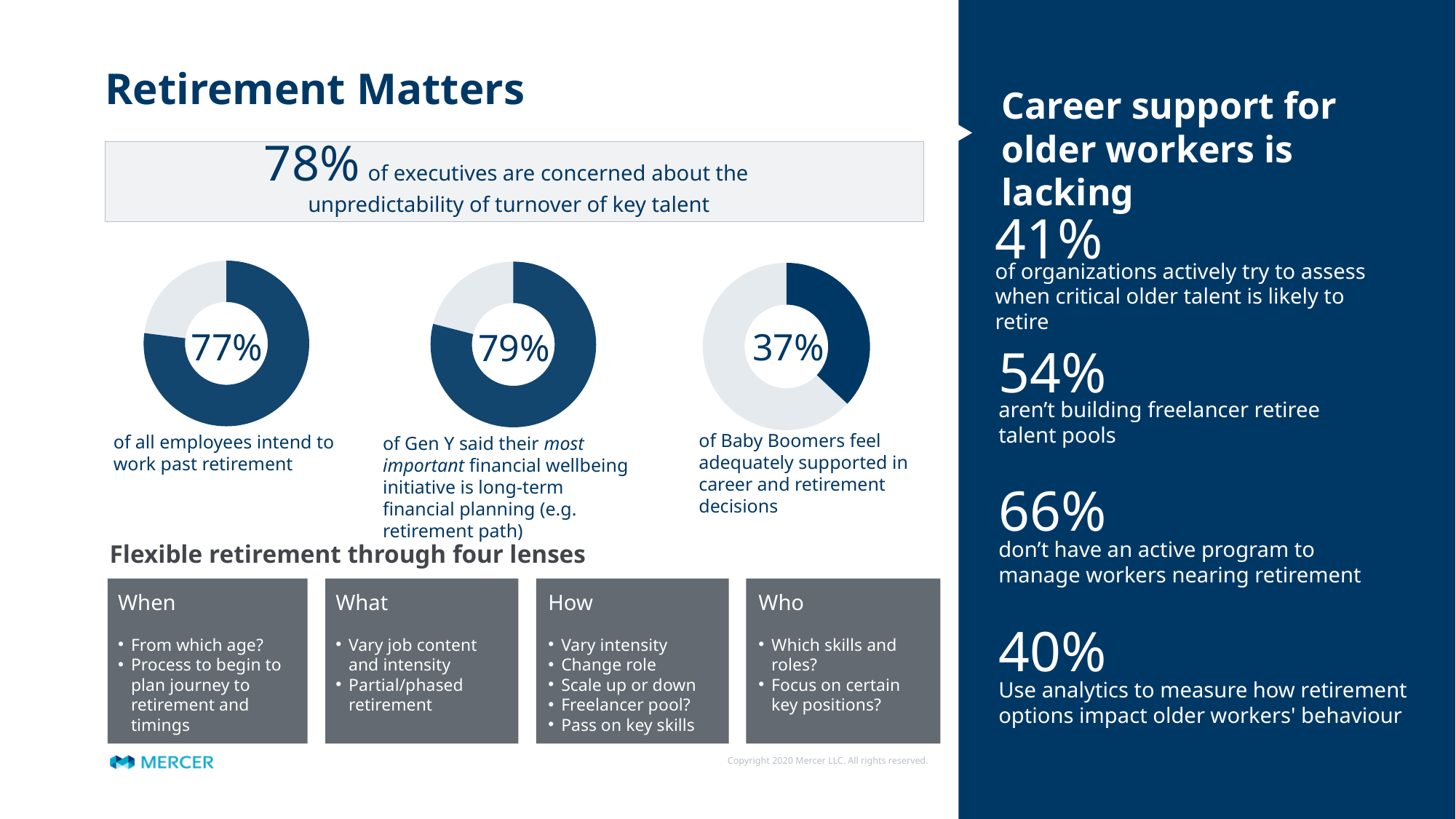
In the right donut chart, is the dark blue filled portion greater or less than 50%? less What percentage is shown in the right donut chart, for Baby Boomers who feel adequately supported in career and retirement decisions? 37% What kind of chart is used to show the 77%, 79% and 37% figures? Donut chart What colour is used for the filled portion of each donut chart? Dark blue What percentage is shown in the middle donut chart, for Gen Y whose most important financial wellbeing initiative is long-term financial planning? 79% What percentage is shown in the left donut chart, for employees who intend to work past retirement? 77% Which of the three donut charts shows the lowest percentage? The right one (Baby Boomers, 37%) What is the difference between the Gen Y donut value and the Baby Boomers donut value? 42 percentage points What share of the left donut chart is not filled in dark blue? 23% Which is larger: the percentage of all employees intending to work past retirement or the percentage of Baby Boomers feeling adequately supported? All employees intending to work past retirement (77%) How many donut charts are shown on the slide? 3 Which of the three donut charts shows the highest percentage? The middle one (Gen Y, 79%)